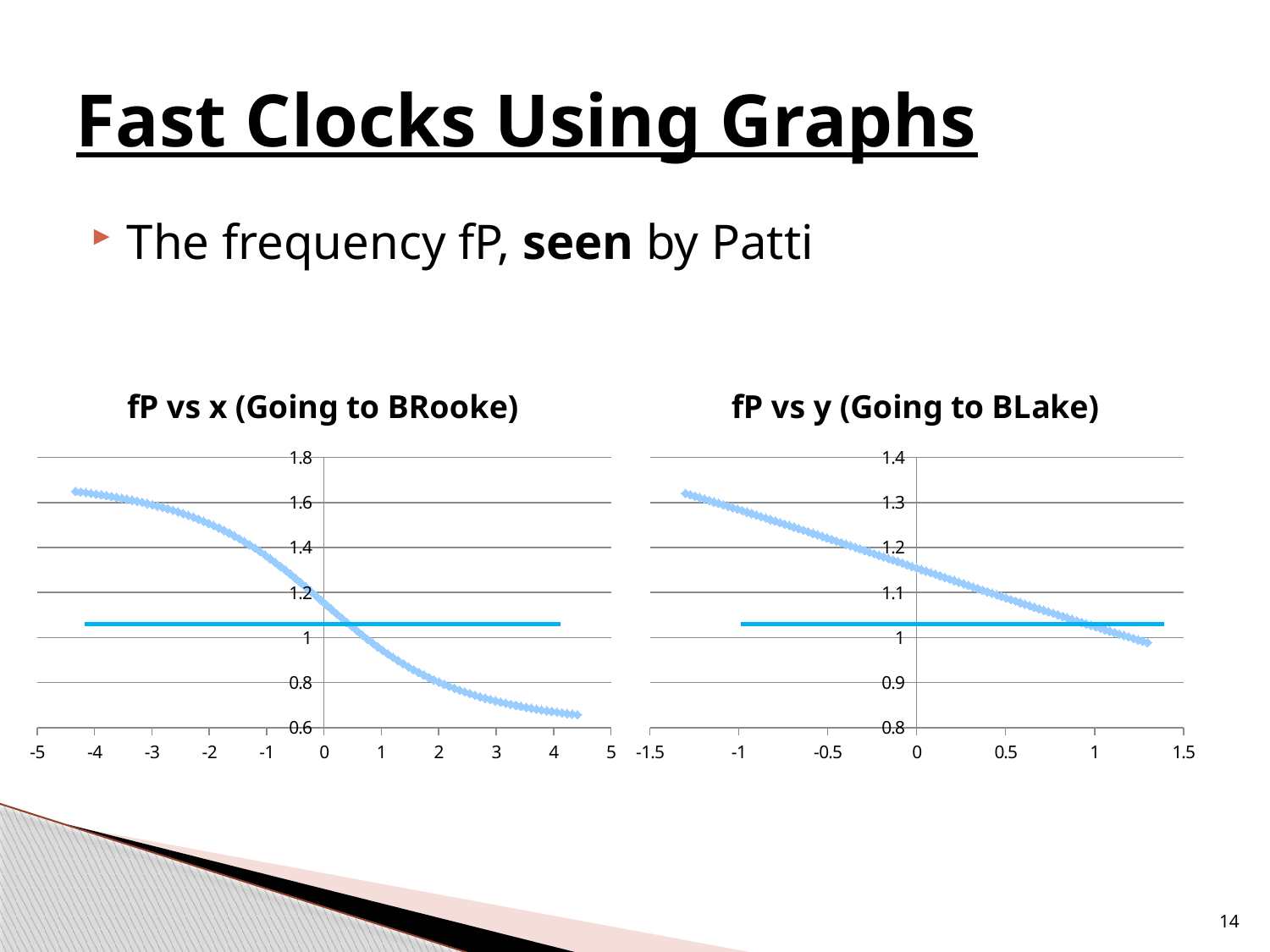
In the chart "fP vs y (Going to BLake)", is the plotted value at y = -1 greater or less than 1.2? greater In the chart "fP vs x (Going to BRooke)", is the plotted value at x = 2 greater or less than 1? less In the chart "fP vs x (Going to BRooke)", is the plotted value at x = 4 greater or less than 0.8? less In the chart "fP vs x (Going to BRooke)", do the plotted values rise or fall as x increases? Fall In the chart "fP vs y (Going to BLake)", do the plotted values rise or fall as y increases? Fall What is the title of the chart on the right of the slide? fP vs y (Going to BLake) What is the highest value shown on the vertical axis of the left chart "fP vs x (Going to BRooke)"? 1.8 How many charts are shown on the slide? 2 What kind of chart is the left chart titled "fP vs x (Going to BRooke)"? Scatter (line) chart